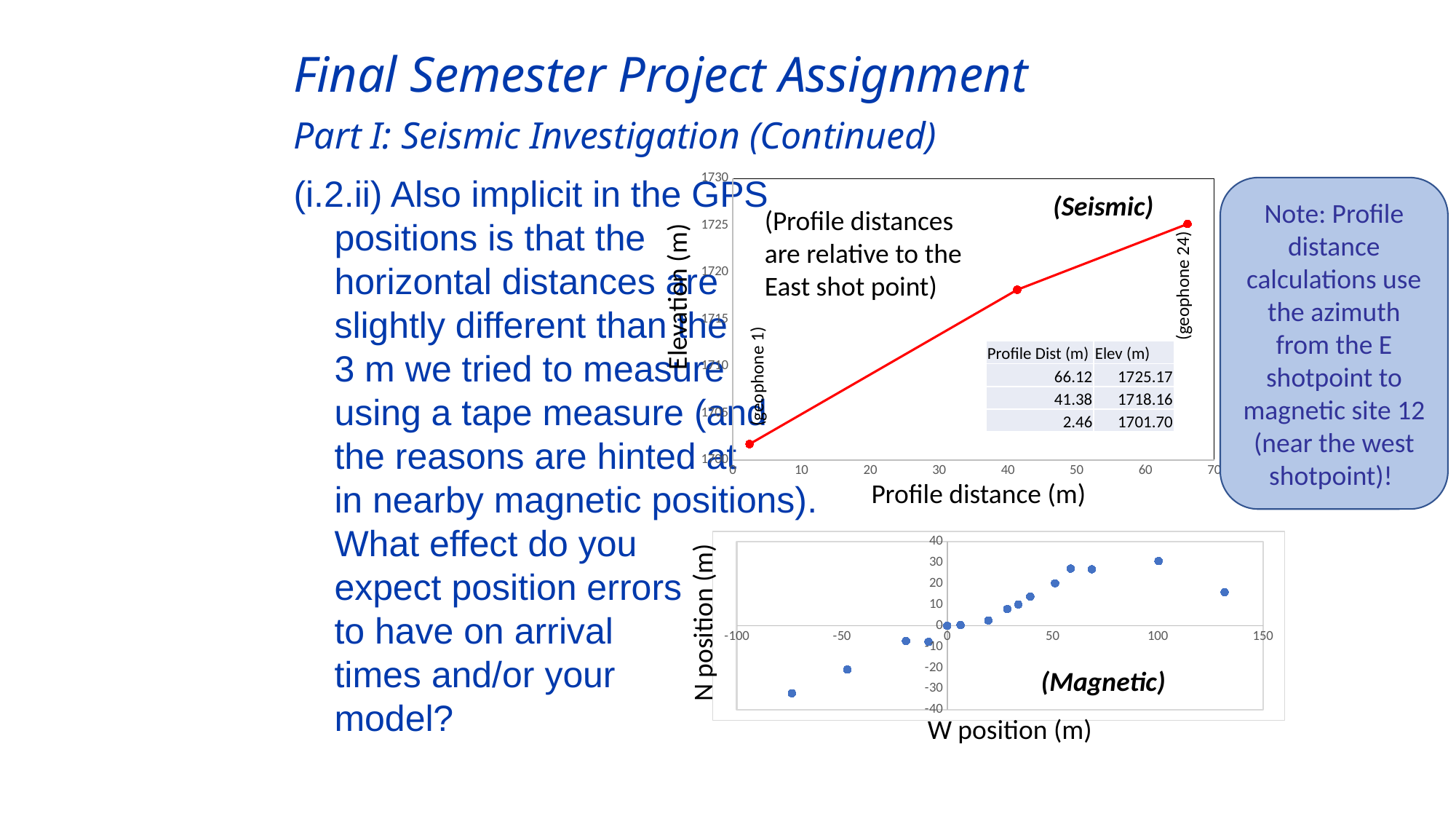
In the Seismic chart, what is the elevation at a profile distance of 41.38 m? 1718.16 In the Seismic chart, what is the elevation at a profile distance of 2.46 m? 1701.70 In the Seismic chart, what is the elevation at a profile distance of 66.12 m? 1725.17 In the Seismic chart, what is the difference in elevation between the points at 66.12 m and 2.46 m? 23.47 In the Seismic chart, does elevation rise or fall as profile distance increases? rises What is the x-axis title of the Magnetic chart? W position (m) In the Seismic chart, at which profile distance is the elevation highest? 66.12 What kind of chart is the Magnetic chart? scatter chart In the Seismic chart, what is the difference in elevation between the points at 41.38 m and 2.46 m? 16.46 What kind of chart is the Seismic chart? line chart How many data points are plotted in the Seismic chart? 3 In the Magnetic chart, is the lowest N position value greater or less than -20? less